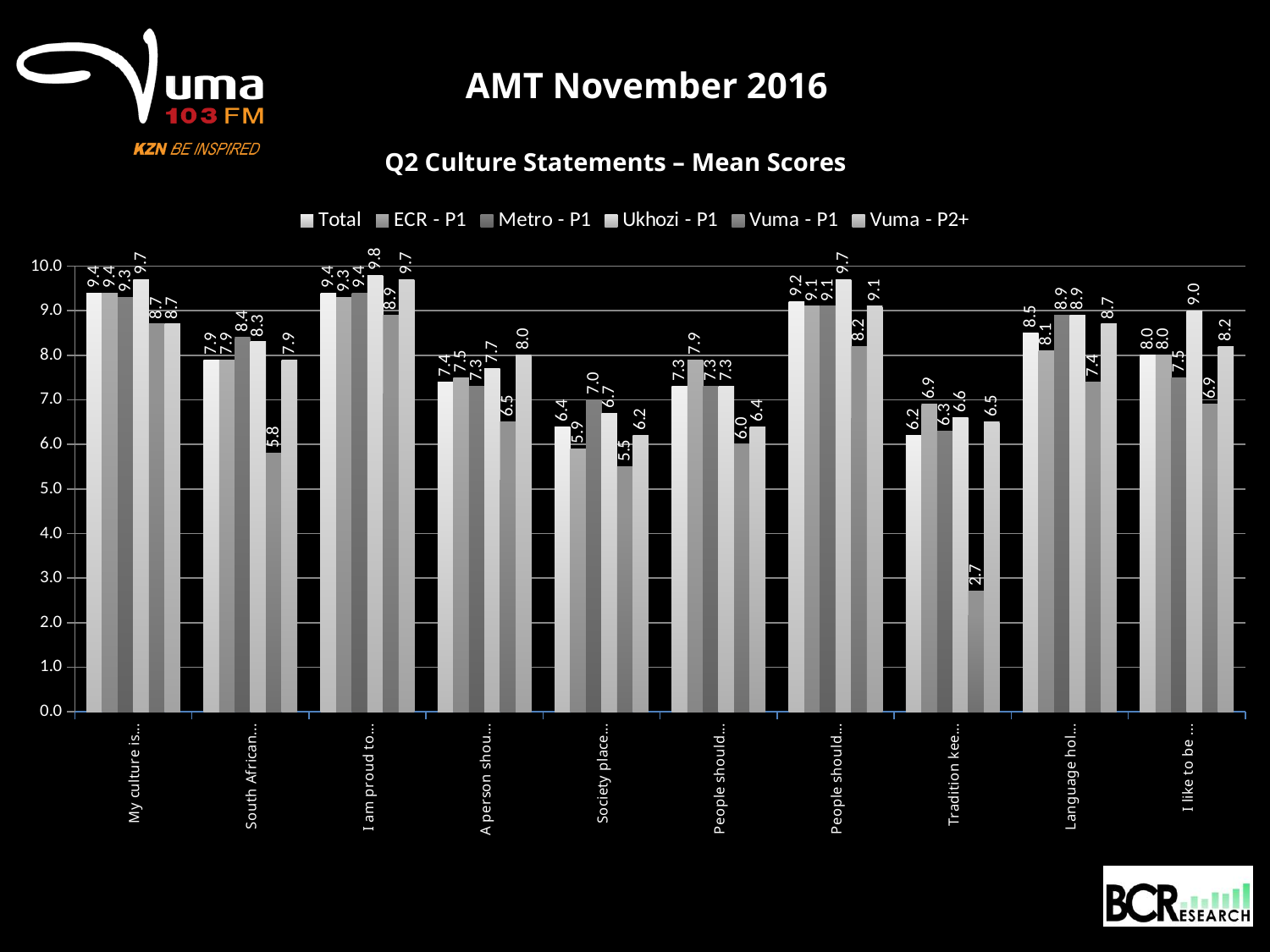
What is the difference between the Vuma - P2+ and Vuma - P1 values for the 'A person shou...' category? 1.5 What is the Total value for the 'Society place...' category? 6.4 Which is larger for the 'Language hol...' category: the Total value or the ECR - P1 value? Total What is the title of the chart? Q2 Culture Statements – Mean Scores What type of chart is shown on the slide? bar chart Is the Vuma - P1 value for the 'Tradition kee...' category greater or less than 3.0? less How many series does the legend list? 6 Which series has the highest value in the 'I like to be ...' category? Ukhozi - P1 What is the Ukhozi - P1 value for the 'I am proud to...' category? 9.8 Which series has the lowest value in the 'South African...' category? Vuma - P1 How many categories are shown along the x axis? 10 What is the Vuma - P1 value for the 'Tradition kee...' category? 2.7